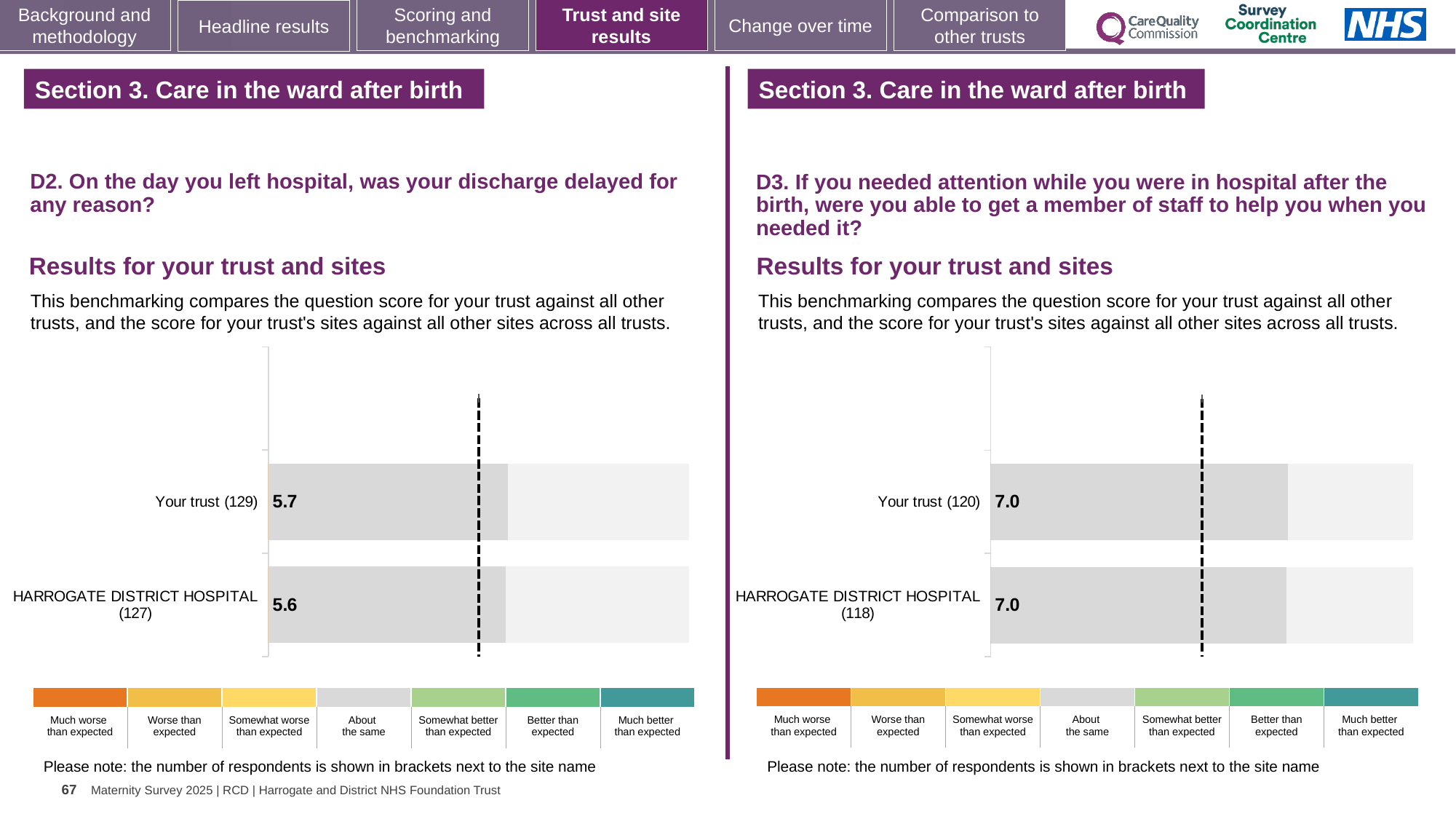
In the D2 chart on the left, is the score for Your trust (129) larger or smaller than the score for HARROGATE DISTRICT HOSPITAL (127)? larger How many bars are plotted in the D3 chart on the right? 2 How many categories does the colour key below the D2 chart on the left list? 7 In the D2 chart on the left, what is the difference between the score for Your trust and the score for HARROGATE DISTRICT HOSPITAL? 0.1 In the D3 chart on the right, what is the score for Your trust (120)? 7.0 In the D2 chart on the left, which bar has the lower score? HARROGATE DISTRICT HOSPITAL (127) What type of chart is used in the D2 chart on the left? bar chart In the D3 chart on the right, what is the difference between the score for Your trust and the score for HARROGATE DISTRICT HOSPITAL? 0.0 In the D2 chart on the left, what is the score for HARROGATE DISTRICT HOSPITAL (127)? 5.6 In the D3 chart on the right, what is the score for HARROGATE DISTRICT HOSPITAL (118)? 7.0 In the D2 chart on the left, which bar has the higher score? Your trust (129) In the D2 chart on the left, what is the score for Your trust (129)? 5.7